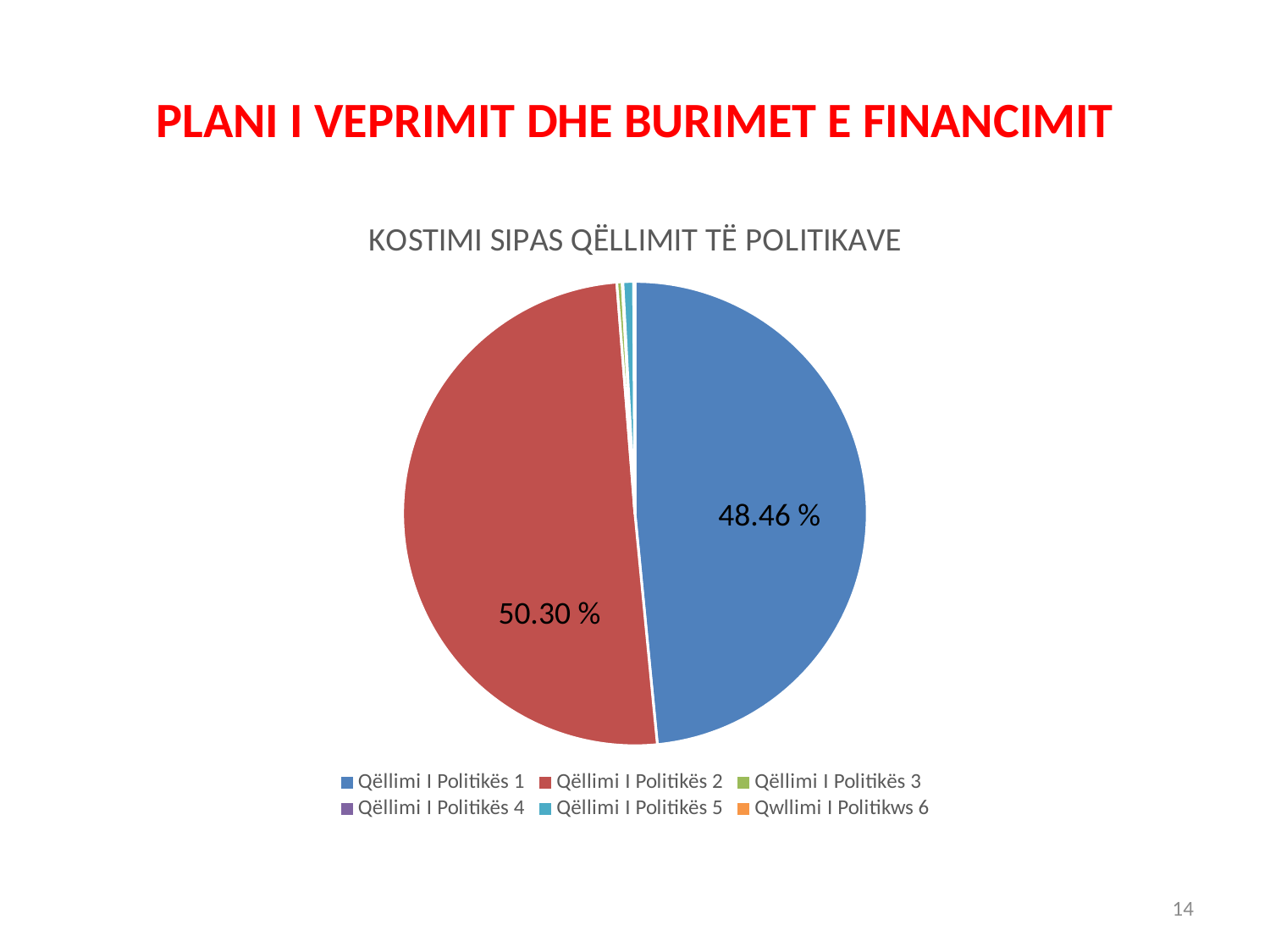
What is the title of the chart? KOSTIMI SIPAS QËLLIMIT TË POLITIKAVE What share of the pie does Qëllimi I Politikës 1 represent? 48.46 % What kind of chart is shown on the slide? Pie chart Which is larger, the slice for Qëllimi I Politikës 1 or the slice for Qëllimi I Politikës 2? Qëllimi I Politikës 2 What share of the pie does Qëllimi I Politikës 2 represent? 50.30 % Is the share for Qëllimi I Politikës 1 greater or less than 50%? less What colour is the slice for Qëllimi I Politikës 1? Blue Which category has the largest slice of the pie? Qëllimi I Politikës 2 Is the share for Qëllimi I Politikës 2 greater or less than 50%? greater How many categories does the legend of the pie chart list? 6 What is the difference between the shares of Qëllimi I Politikës 2 and Qëllimi I Politikës 1? 1.84 %